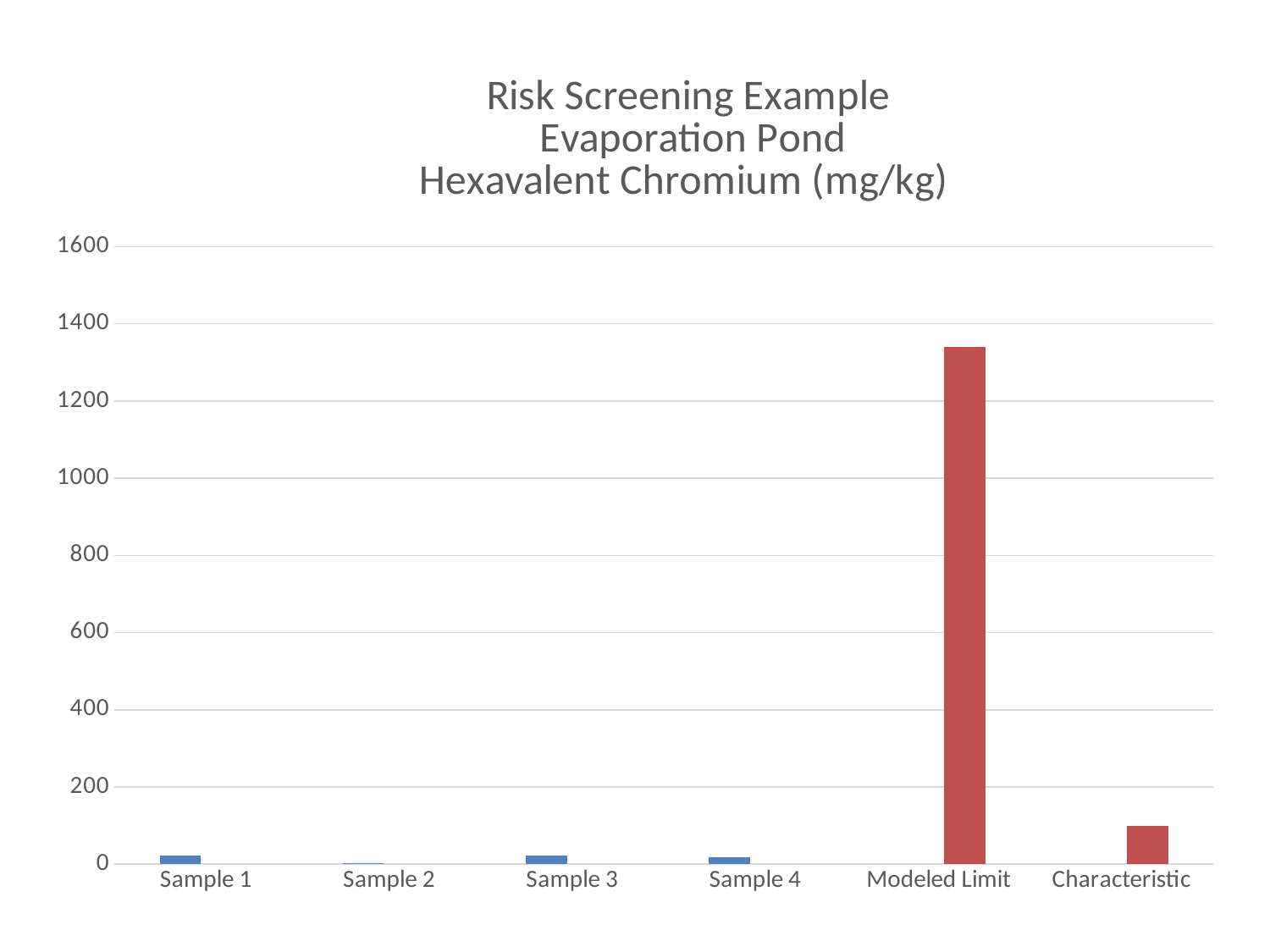
What unit is given in the chart title for hexavalent chromium? mg/kg Is the value for Characteristic greater or less than 200? less Is the value for Modeled Limit greater or less than 1200? greater Which category has the highest value? Modeled Limit Is the value for Sample 1 greater or less than 200? less Which is larger, the value for Modeled Limit or the value for Characteristic? Modeled Limit Which is larger, the value for Sample 3 or the value for Sample 2? Sample 3 How many categories are plotted on the x axis? 6 Which category has the lowest value? Sample 2 What colour are the bars for Modeled Limit and Characteristic? red What kind of chart is shown on the slide? bar chart